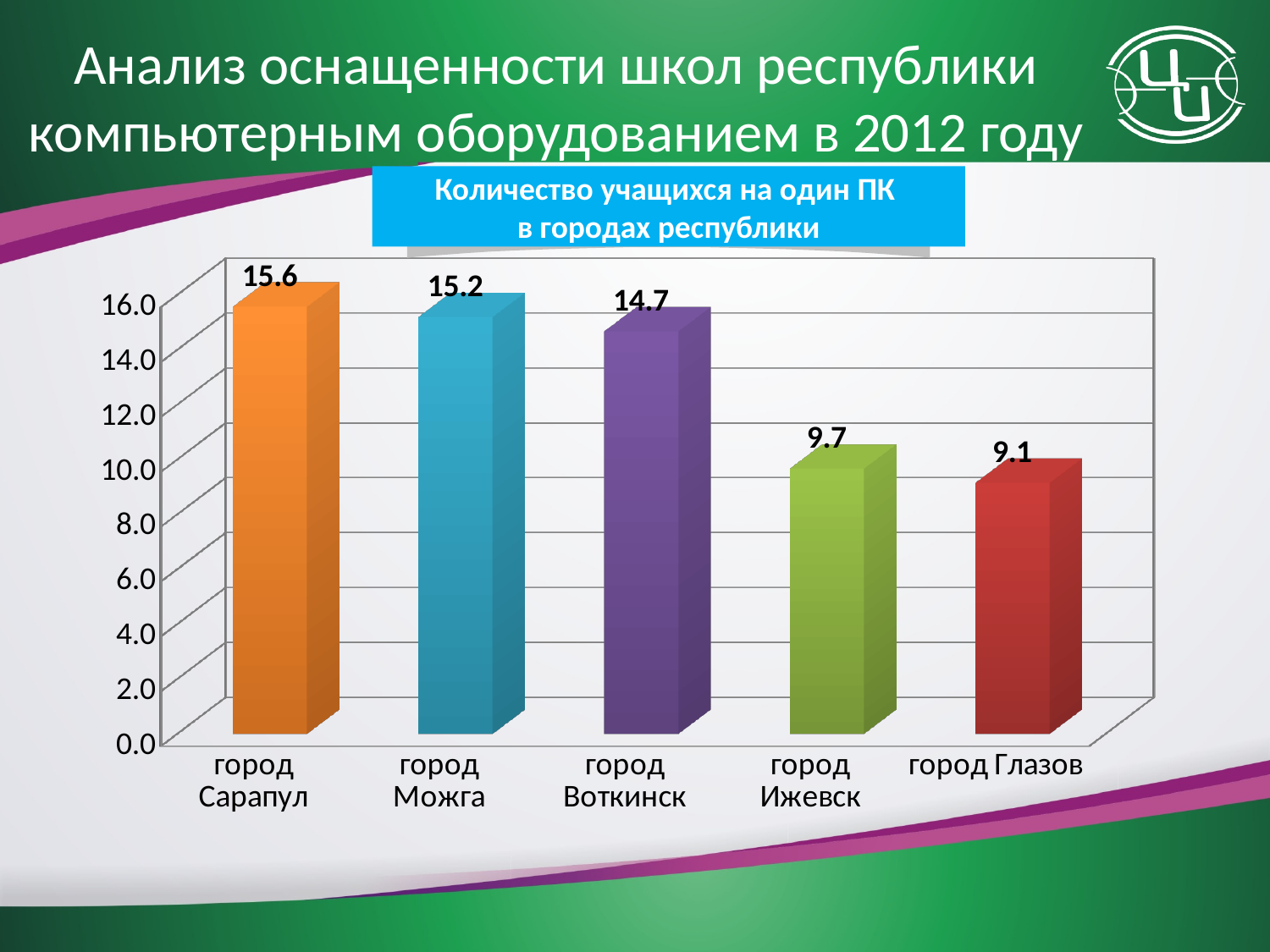
What is the value for город Сарапул? 15.6 How many cities are shown on the chart? 5 What is the value for город Воткинск? 14.7 Which is larger, the value for город Воткинск or the value for город Ижевск? город Воткинск What is the value for город Ижевск? 9.7 What kind of chart is shown on the slide? bar chart Which city has the highest value? город Сарапул Is the value for город Глазов greater or less than 10.0? less What is the title of the chart? Количество учащихся на один ПК в городах республики What is the difference between the values for город Сарапул and город Глазов? 6.5 What is the difference between the values for город Можга and город Ижевск? 5.5 Which city has the lowest value? город Глазов